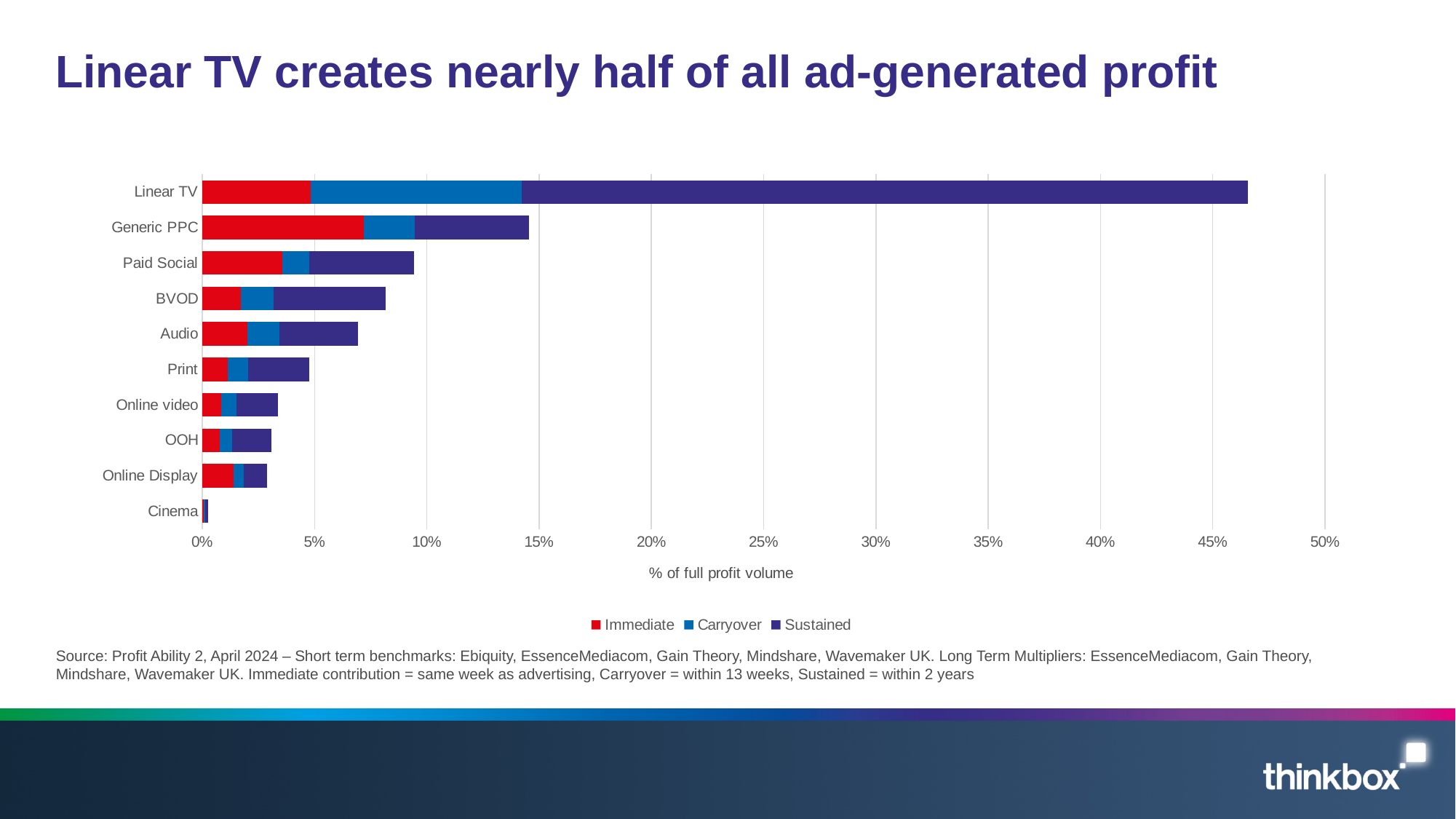
Which has a larger total bar, Generic PPC or Paid Social? Generic PPC Is the total value for Generic PPC greater or less than 10%? greater Which channel has the highest total share of full profit volume? Linear TV What kind of chart is shown on the slide? Stacked bar chart What is the label on the horizontal axis of the chart? % of full profit volume Which series is shown in red in the legend? Immediate How many media channels (categories) are plotted on the chart? 10 Which channel has the lowest total share of full profit volume? Cinema How many series does the legend list? 3 Is the total value for Online video greater or less than 5%? less Which has a larger total bar, Audio or Print? Audio Is the total value for Linear TV greater or less than 45%? greater